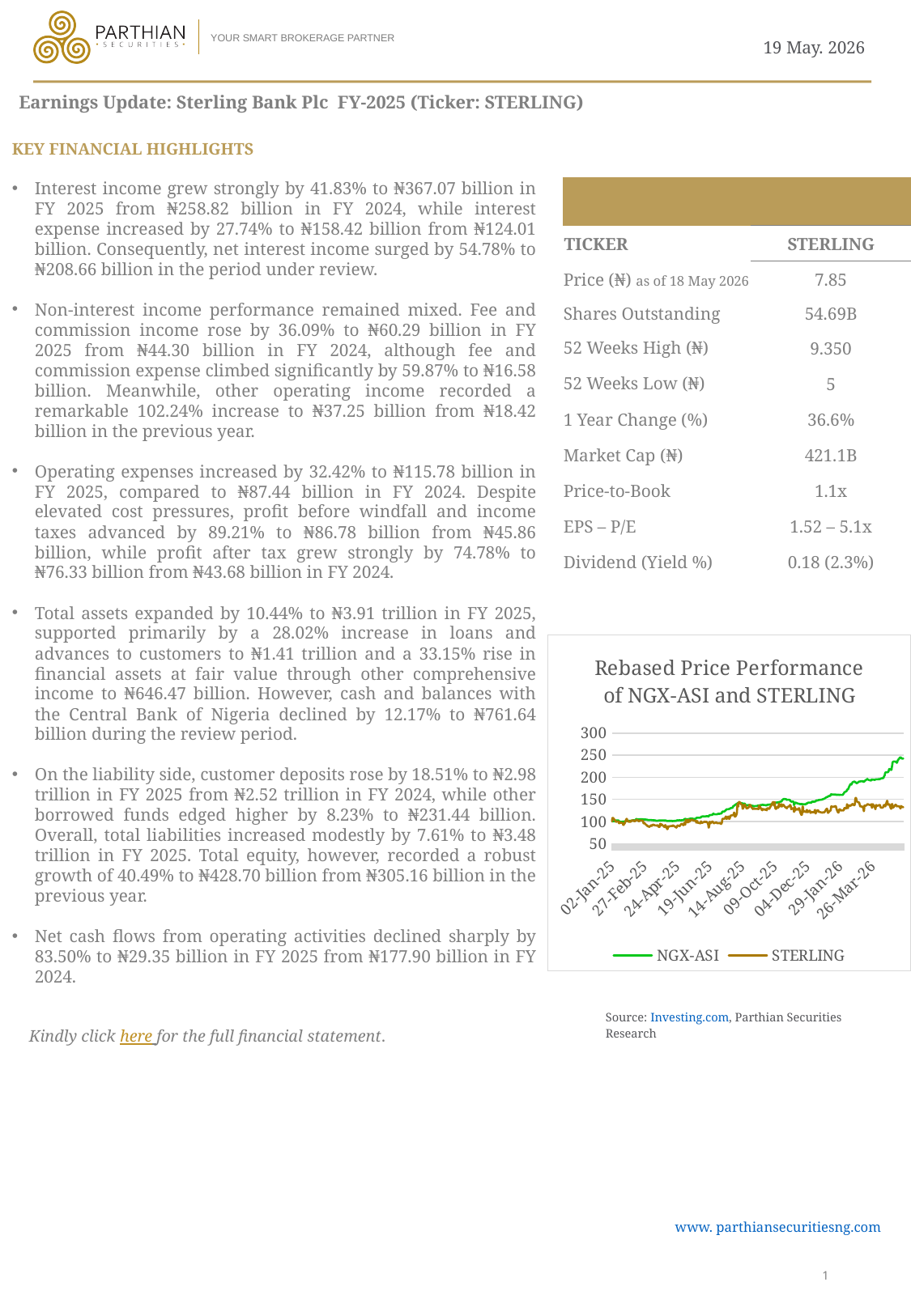
How many date labels are shown on the x axis of the chart? 9 What is the title of the chart? Rebased Price Performance of NGX-ASI and STERLING Which two series are listed in the chart's legend? NGX-ASI and STERLING Around 27-Feb-25, is the value for STERLING greater or less than 150? less At the end of the chart (after 26-Mar-26), is the value for STERLING greater or less than 200? less Around 29-Jan-26, is the value for NGX-ASI greater or less than 150? greater How many series does the chart's legend list? 2 At the end of the chart, which series has the higher value, NGX-ASI or STERLING? NGX-ASI What kind of chart is shown on the slide? line chart Does the NGX-ASI line rise or fall overall from 02-Jan-25 to the end of the chart? rise What is the highest value shown on the chart's y axis? 300